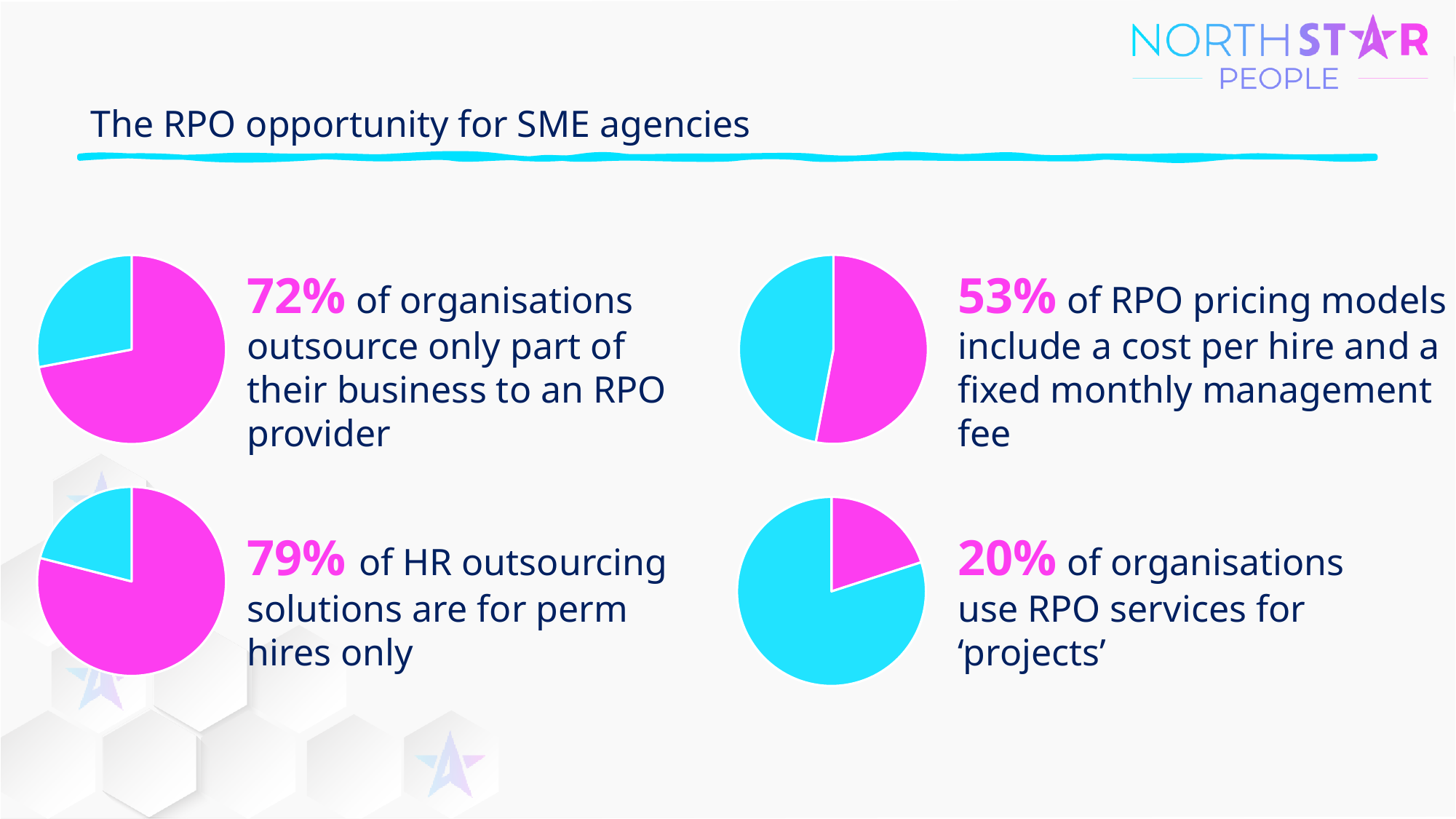
In the top-right pie chart, what percentage of RPO pricing models include a cost per hire and a fixed monthly management fee? 53% What kind of chart is shown at the top-left of the slide? pie chart In the bottom-right pie chart, what colour is the larger slice? cyan How many pie charts are on the slide? 4 In the bottom-right pie chart, what share of the pie does the cyan slice represent? 80% Which pie chart has the smallest magenta slice: the top-left, top-right, bottom-left or bottom-right? bottom-right In the bottom-right pie chart, what percentage of organisations use RPO services for 'projects'? 20% In the top-left pie chart, what share of the pie does the cyan slice represent? 28% In the bottom-left pie chart, what percentage of HR outsourcing solutions are for perm hires only? 79% Which pie chart has the largest magenta slice: the top-left, top-right, bottom-left or bottom-right? bottom-left In the top-left pie chart, what percentage does the magenta slice represent (organisations that outsource only part of their business to an RPO provider)? 72% Which is larger: the magenta slice in the top-left pie chart or the magenta slice in the bottom-right pie chart? top-left